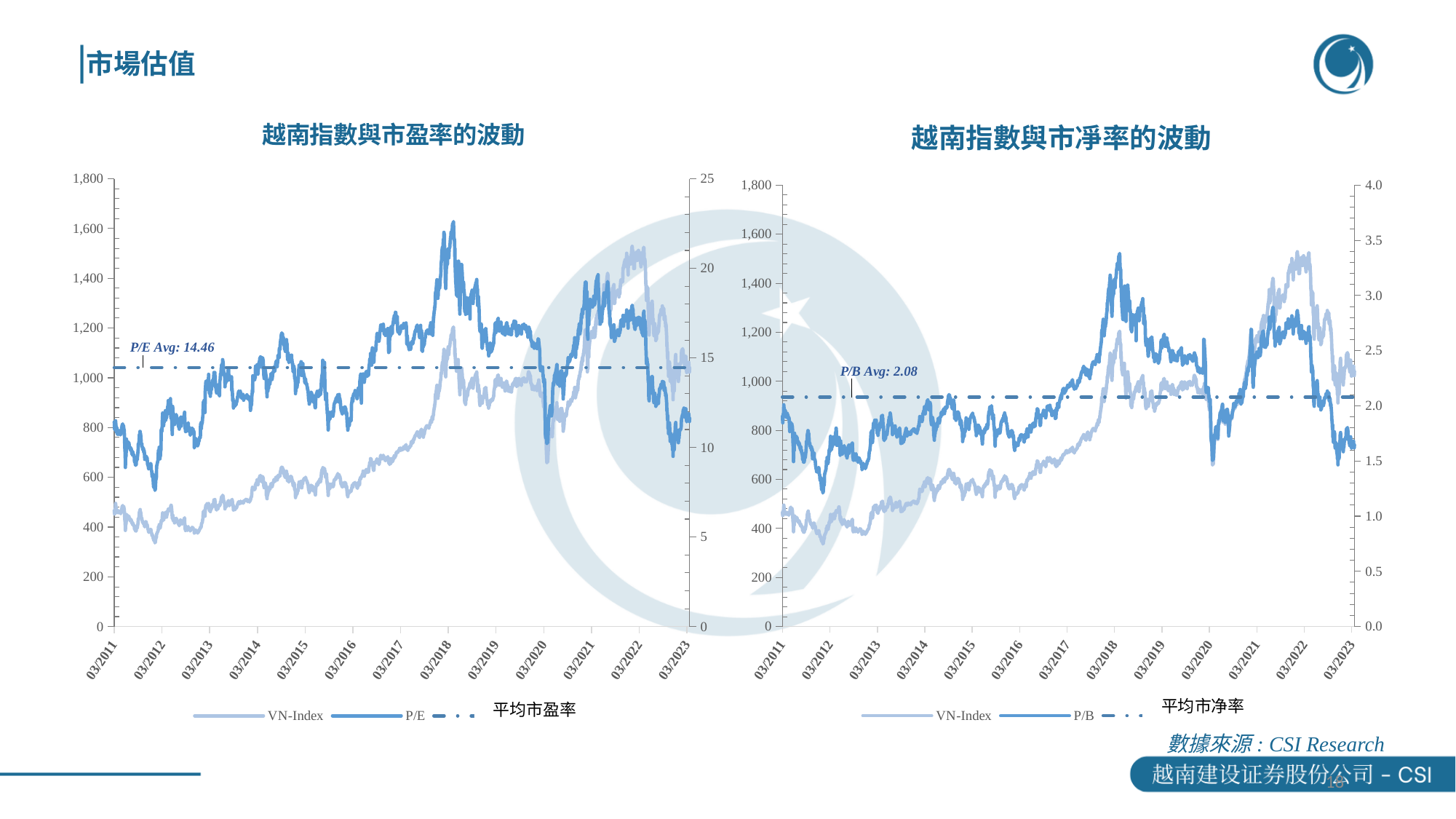
How many date labels are shown on the x axis of the left chart (越南指數與市盈率的波動)? 13 In the right chart (越南指數與市淨率的波動), does the VN-Index overall rise or fall from 03/2011 to 03/2023? rise In the left chart (越南指數與市盈率的波動), what is the average P/E value printed on the chart? 14.46 What kind of chart is the left chart titled 越南指數與市盈率的波動? line chart In the right chart (越南指數與市淨率的波動), what is the average P/B value printed on the chart? 2.08 What kind of chart is the right chart titled 越南指數與市淨率的波動? line chart In the left chart (越南指數與市盈率的波動), is the VN-Index value at 03/2012 greater or less than 600? less How many series does the legend of the right chart (越南指數與市淨率的波動) list? 3 How many series does the legend of the left chart (越南指數與市盈率的波動) list? 3 In the right chart (越南指數與市淨率的波動), is the P/B value at its peak around 03/2018 greater or less than 3.0? greater In the left chart (越南指數與市盈率的波動), is the P/E value at its peak around 03/2018 greater or less than 20? greater What is the title of the right chart on the slide? 越南指數與市淨率的波動